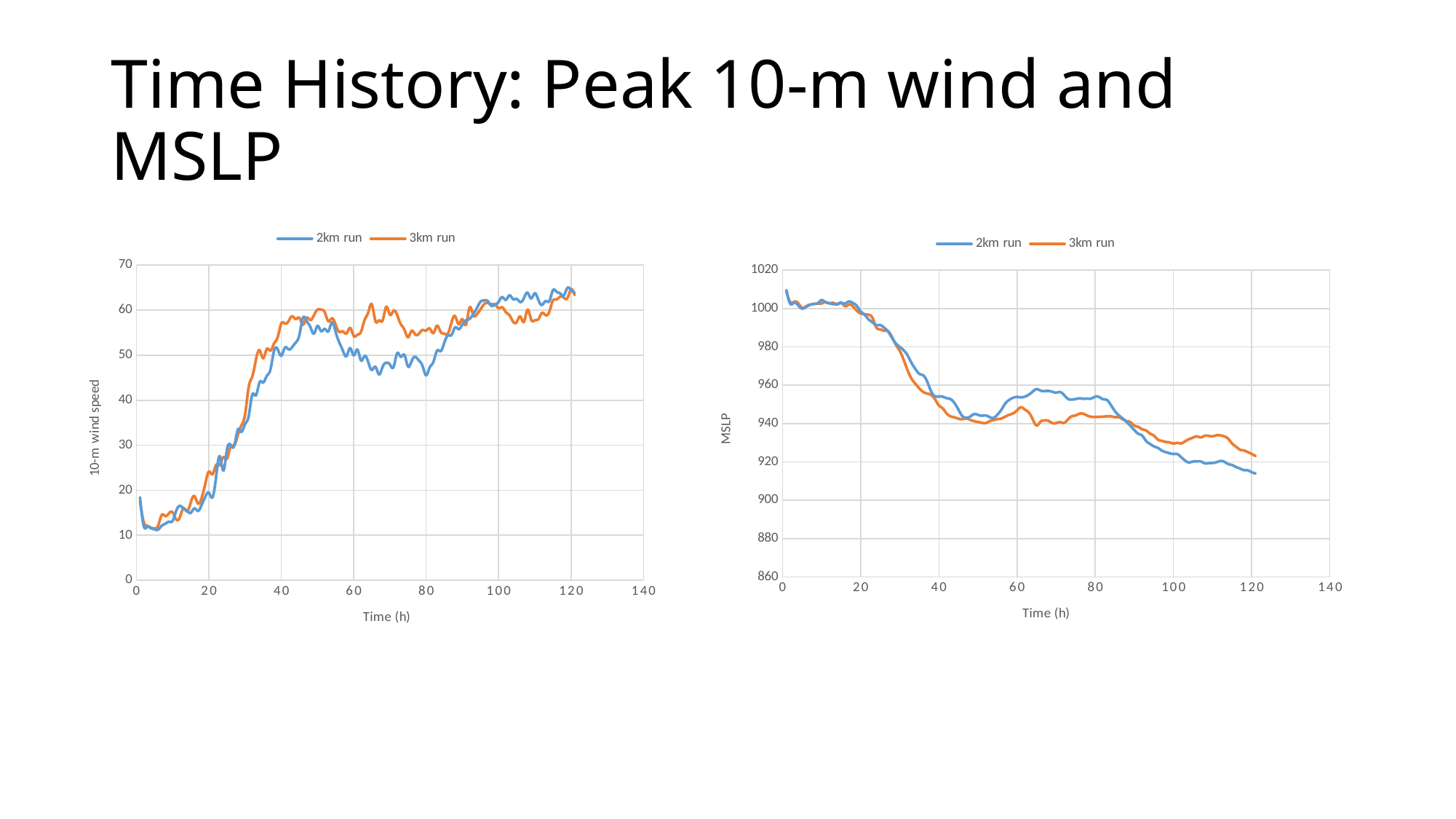
In the left chart (10-m wind speed), is the 2km run value at 80 h greater or less than 50? less In the left chart (10-m wind speed), do the values generally rise or fall as time increases from 0 to 120 h? rise What kind of chart is the left chart (10-m wind speed)? line chart In the right chart (MSLP), is the 2km run value at 60 h greater or less than 940? greater In the left chart (10-m wind speed), is the 3km run value at 80 h greater or less than 50? greater In the right chart (MSLP), do the values generally rise or fall as time increases from 0 to 120 h? fall How many series does the legend of the left chart (10-m wind speed) list? 2 In the right chart (MSLP), what are the two series named in the legend? 2km run and 3km run In the left chart (10-m wind speed), which series has the higher value at 80 h, 2km run or 3km run? 3km run What kind of chart is the right chart (MSLP)? line chart In the right chart (MSLP), which series has the higher value at 65 h, 2km run or 3km run? 2km run